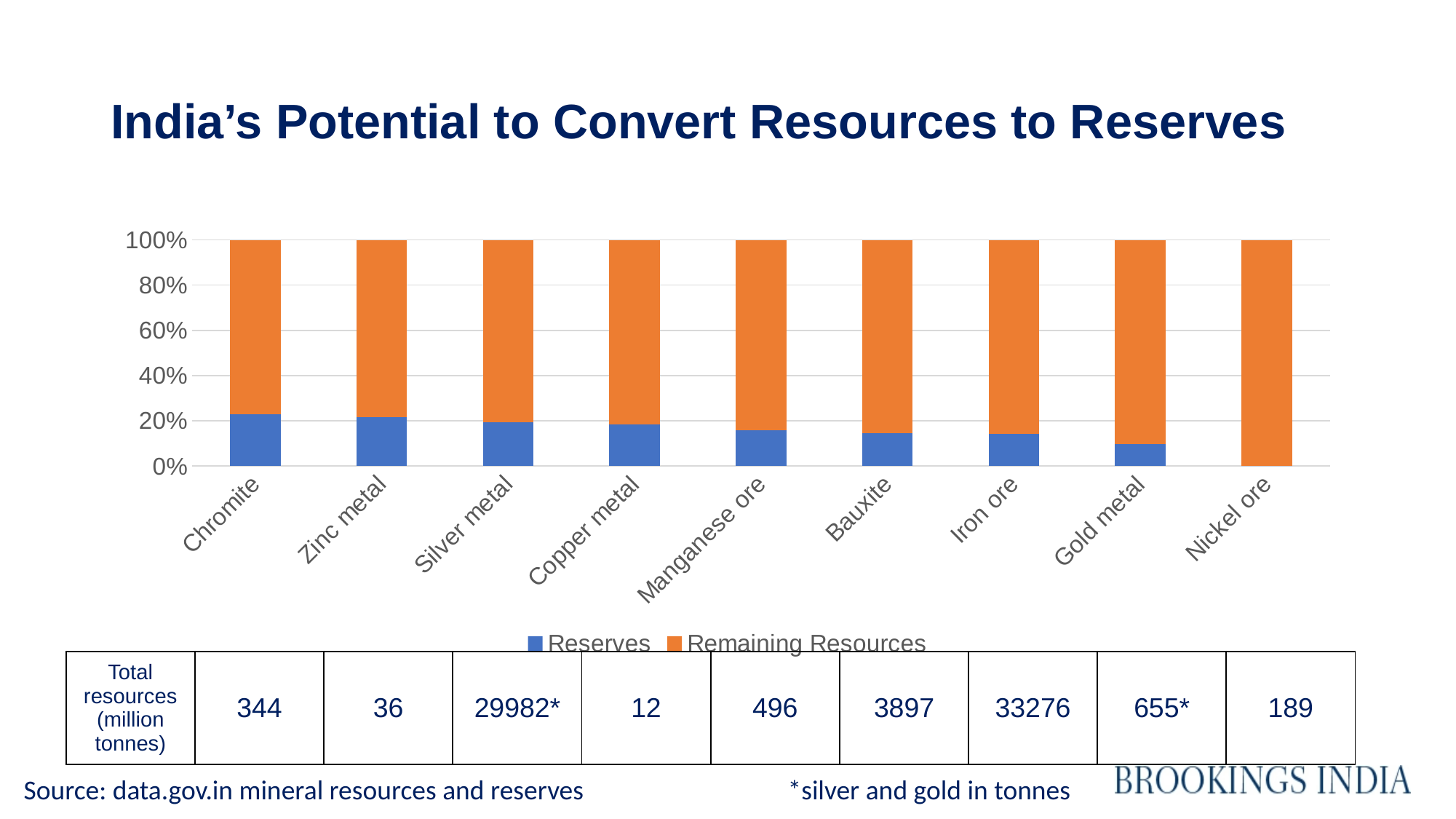
Is the Reserves share for Gold metal greater or less than 20%? less Which mineral has the lowest Reserves share in the chart? Nickel ore Is the Reserves share for Chromite greater or less than 20%? greater Which two series are listed in the chart legend? Reserves and Remaining Resources What kind of chart is shown on the slide? bar chart What does each stacked bar in the chart total? 100% Which mineral has the highest Reserves share in the chart? Chromite Which has a larger Reserves share, Chromite or Gold metal? Chromite Does the Reserves share rise or fall moving from Chromite to Nickel ore along the x axis? fall What is the title of the chart? India's Potential to Convert Resources to Reserves How many minerals are shown along the x axis of the chart? 9 How many series does the chart legend list? 2